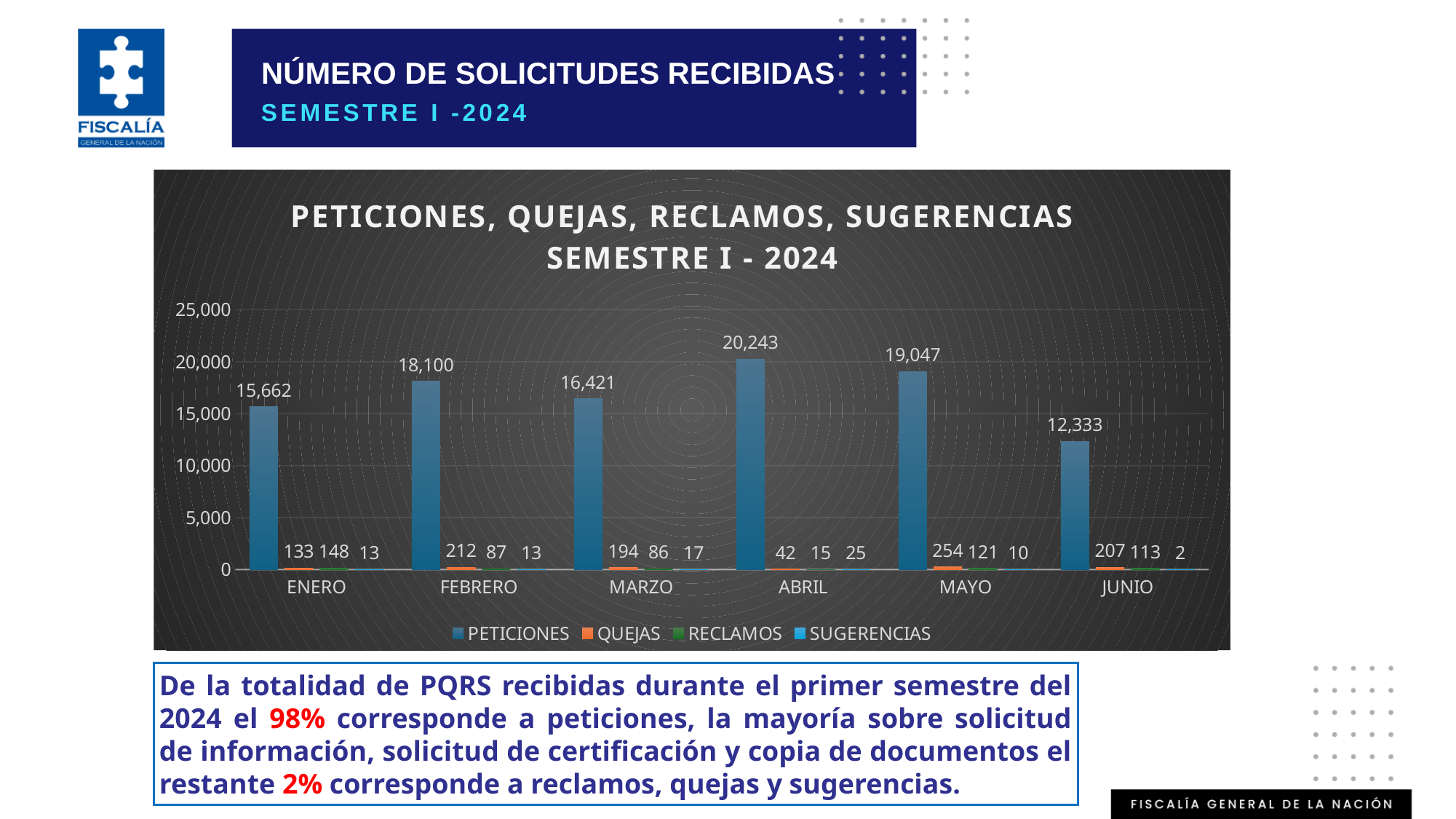
What is the title of the chart? PETICIONES, QUEJAS, RECLAMOS, SUGERENCIAS SEMESTRE I - 2024 What is the value of QUEJAS for MAYO? 254 What is the value of SUGERENCIAS for JUNIO? 2 Which month has the lowest value for PETICIONES? JUNIO What is the value of RECLAMOS for ENERO? 148 What is the value of PETICIONES for ABRIL? 20,243 What kind of chart is shown on the slide? Bar chart How many series does the legend list? 4 How many months are shown on the x axis? 6 Which month has the highest value for PETICIONES? ABRIL What is the difference between PETICIONES in ABRIL and PETICIONES in JUNIO? 7,910 Which is larger, QUEJAS in FEBRERO or QUEJAS in MARZO? QUEJAS in FEBRERO